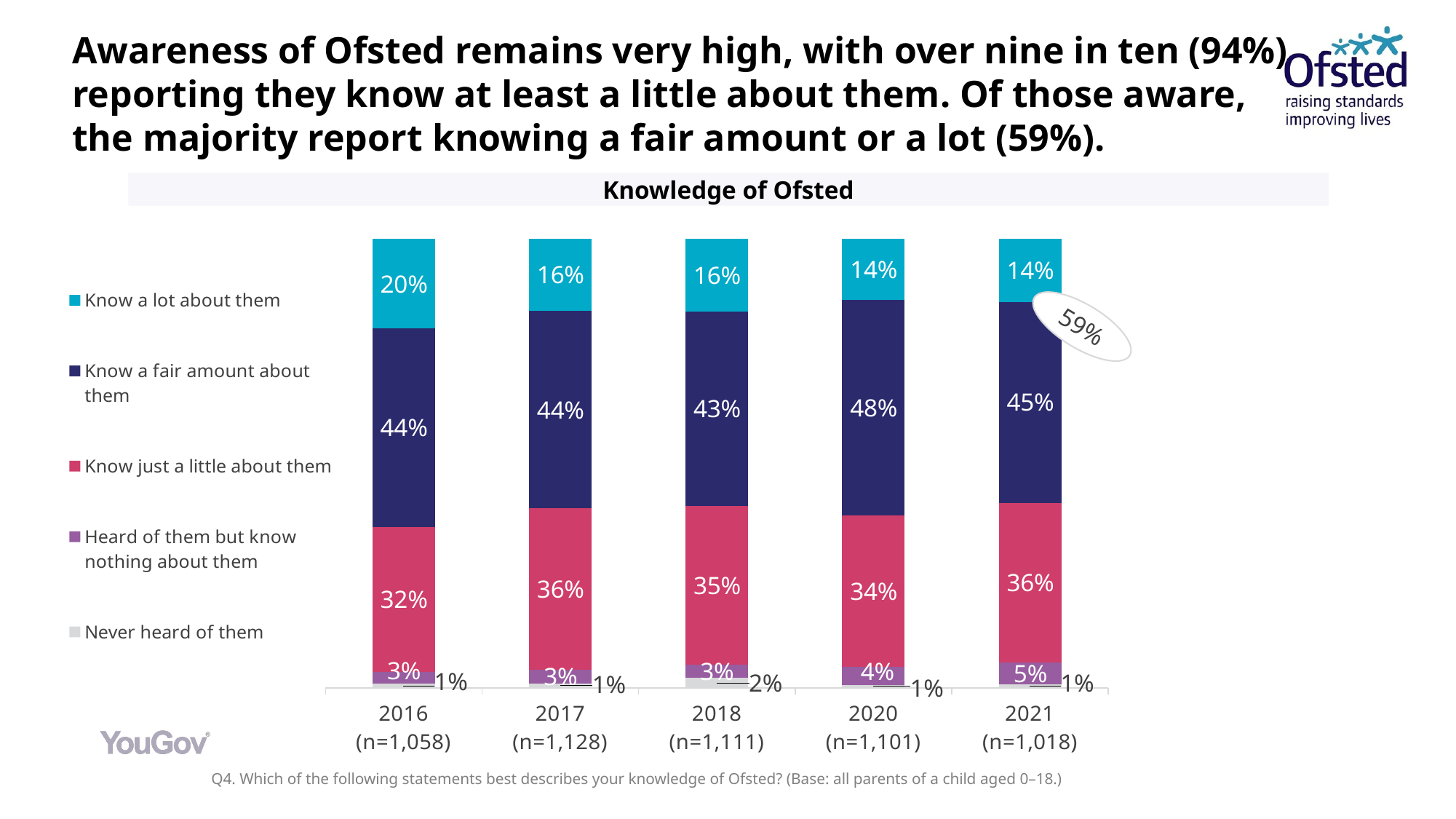
How many series does the legend list? 5 What is the difference between the 'Know a lot about them' share in 2016 and in 2021? 6 percentage points What percentage of respondents said they know a fair amount about Ofsted in 2020? 48% What kind of chart is shown? Stacked bar chart What is the combined share of 'Know a lot about them' and 'Know a fair amount about them' in 2021? 59% How many years are shown on the x axis? 5 In which year was the 'Know a lot about them' share highest? 2016 What percentage of respondents said they know a lot about Ofsted in 2016? 20% Which is larger: the 'Know just a little about them' share in 2016 or in 2017? 2017 What percentage of respondents had heard of Ofsted but knew nothing about them in 2021? 5% In which year was the 'Know a fair amount about them' share lowest? 2018 What percentage of respondents said they know just a little about Ofsted in 2021? 36%